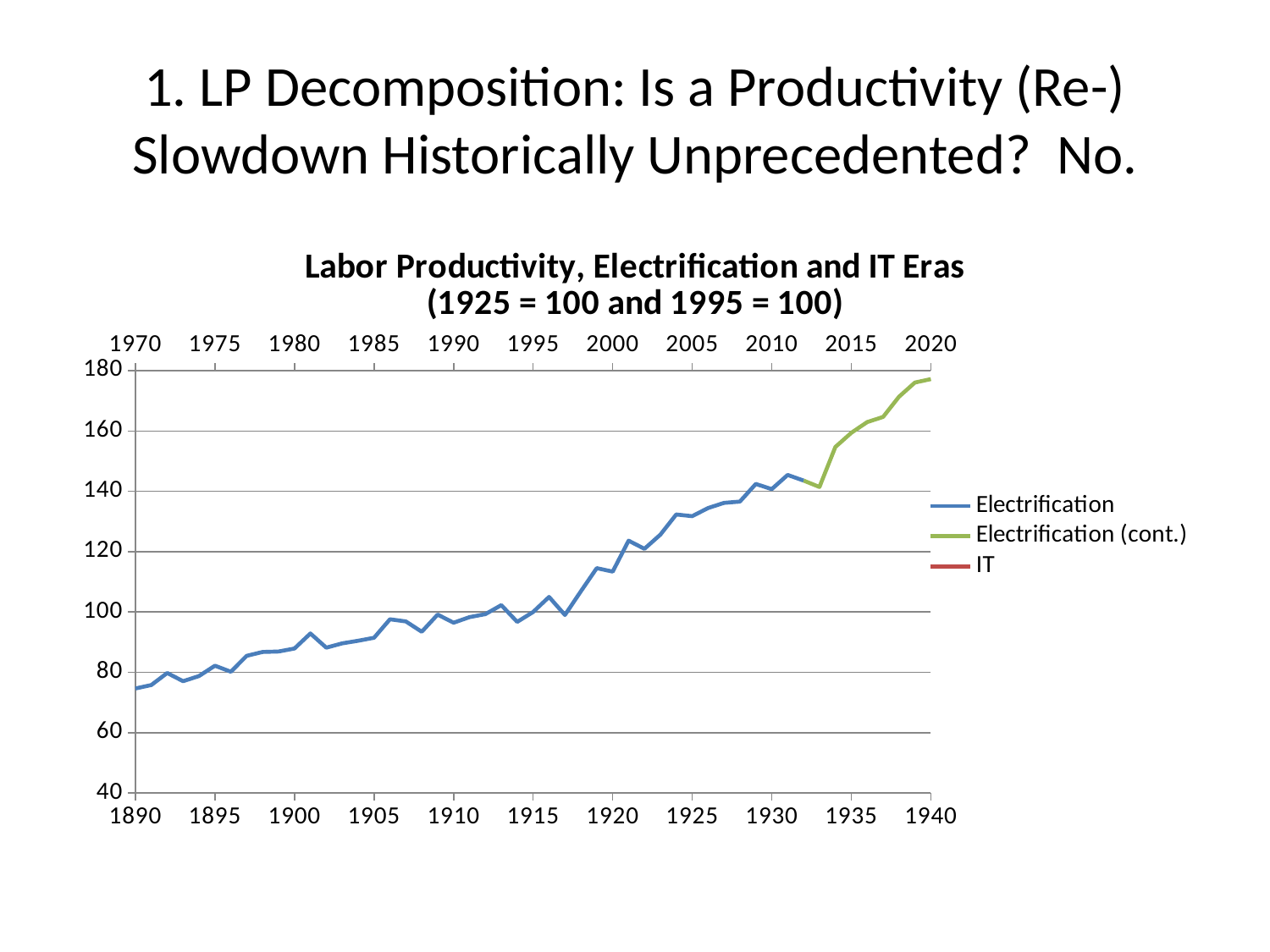
Which is larger, the Electrification value at 1900 or at 1920? 1920 Which series is drawn in green in the legend? Electrification (cont.) Is the Electrification (cont.) value at 1940 greater or less than 160? greater Is the Electrification value at 1930 greater or less than 120? greater Is the Electrification value at 1905 greater or less than 100? less What kind of chart is shown on the slide? line chart How many series does the legend list? 3 What is the title of the chart? Labor Productivity, Electrification and IT Eras (1925 = 100 and 1995 = 100) Which is larger, the value at 1890 or the value at 1940? 1940 Does the plotted line generally rise or fall from 1890 to 1940? rise